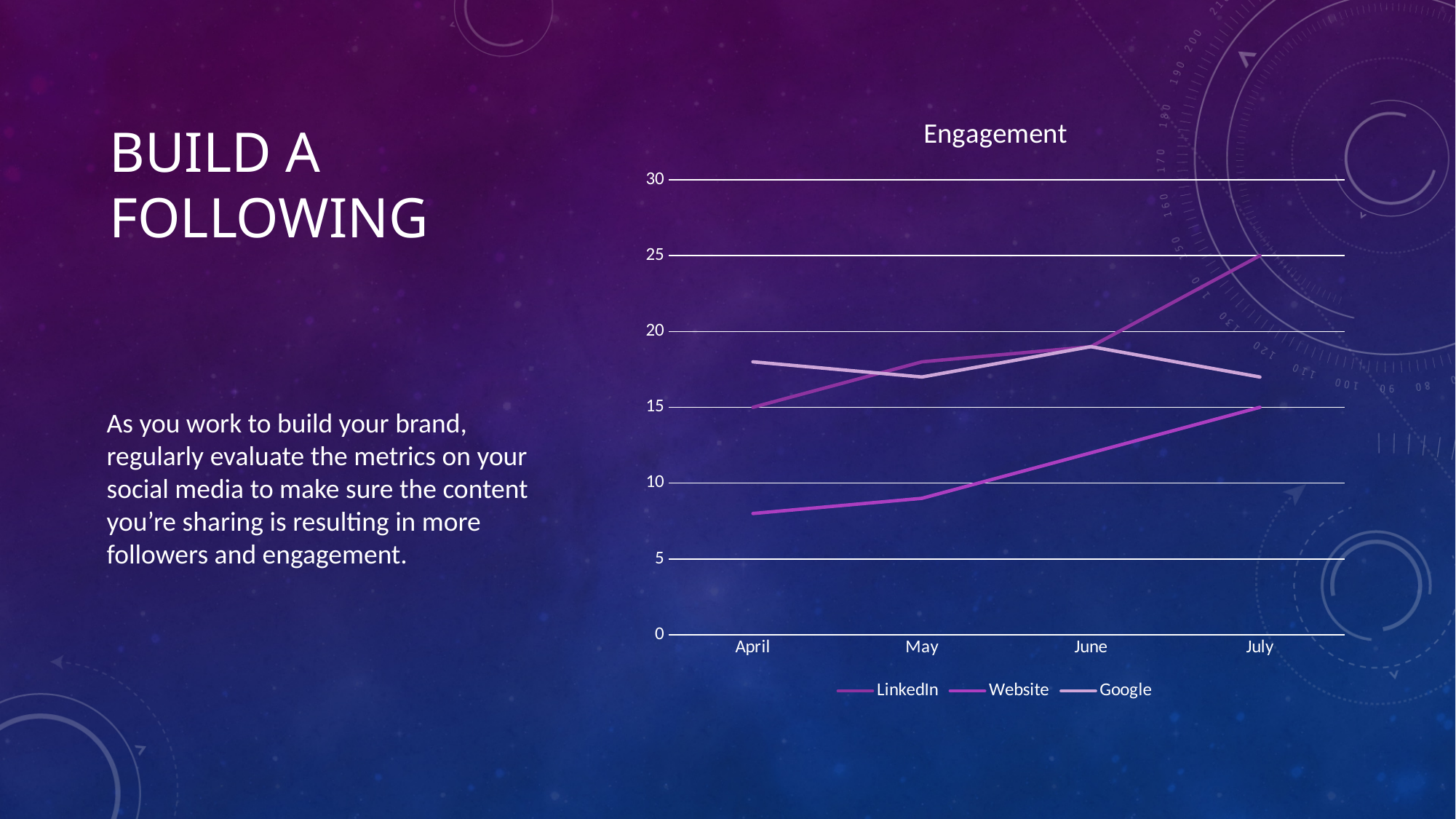
Is the value for Google in June greater or less than 15? greater Does the Website series rise or fall from April to July? rise Which series has the lowest value in April? Website How many series does the legend list? 3 Is the value for Website in April greater or less than 10? less Which series reaches the highest value in July? LinkedIn In July, which is larger, the value for LinkedIn or the value for Google? LinkedIn In April, which is larger, the value for Google or the value for Website? Google Is the value for LinkedIn in July greater or less than 20? greater What kind of chart is shown on the slide? line chart How many months are shown on the x axis? 4 What is the title of the chart? Engagement